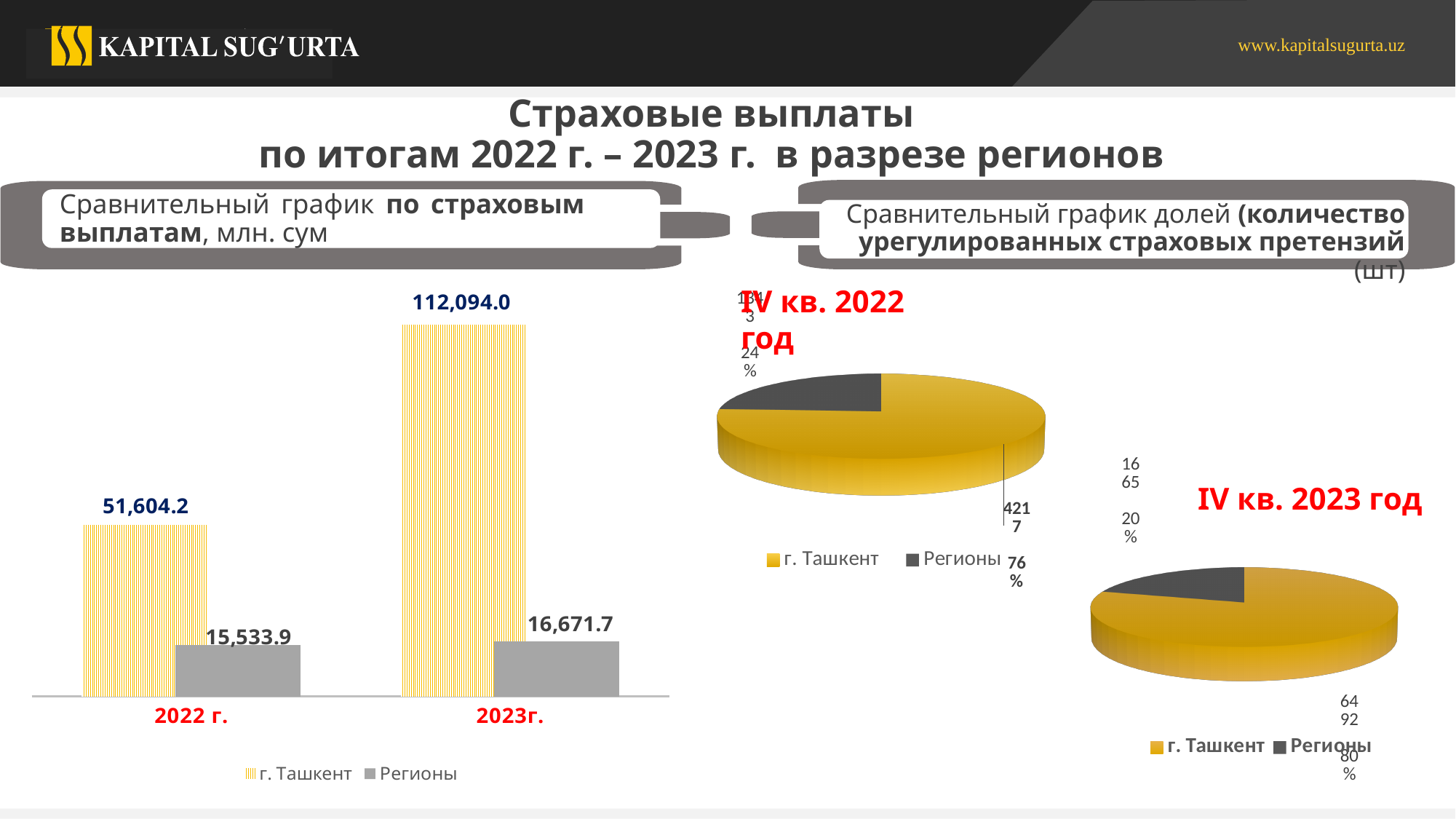
In the bar chart on the left, which bar has the highest value? г. Ташкент in 2023г. In the bar chart on the left, how many series does the legend list? 2 In the pie chart titled IV кв. 2023 год, what share does Регионы have? 20% In the bar chart on the left, which is larger: Регионы in 2022 г. or Регионы in 2023г.? Регионы in 2023г. In the bar chart on the left, what is the value for Регионы in 2022 г.? 15,533.9 In the bar chart on the left, what is the value for г. Ташкент in 2022 г.? 51,604.2 In the bar chart on the left, does the value for г. Ташкент rise or fall from 2022 г. to 2023г.? Rise In the bar chart on the left, what is the value for Регионы in 2023г.? 16,671.7 What kind of chart is the chart on the left of the slide? Bar chart In the pie chart titled IV кв. 2022 год, what share does г. Ташкент have? 76% In the bar chart on the left, what is the difference between the г. Ташкент values for 2023г. and 2022 г.? 60,489.8 In the bar chart on the left, what is the value for г. Ташкент in 2023г.? 112,094.0